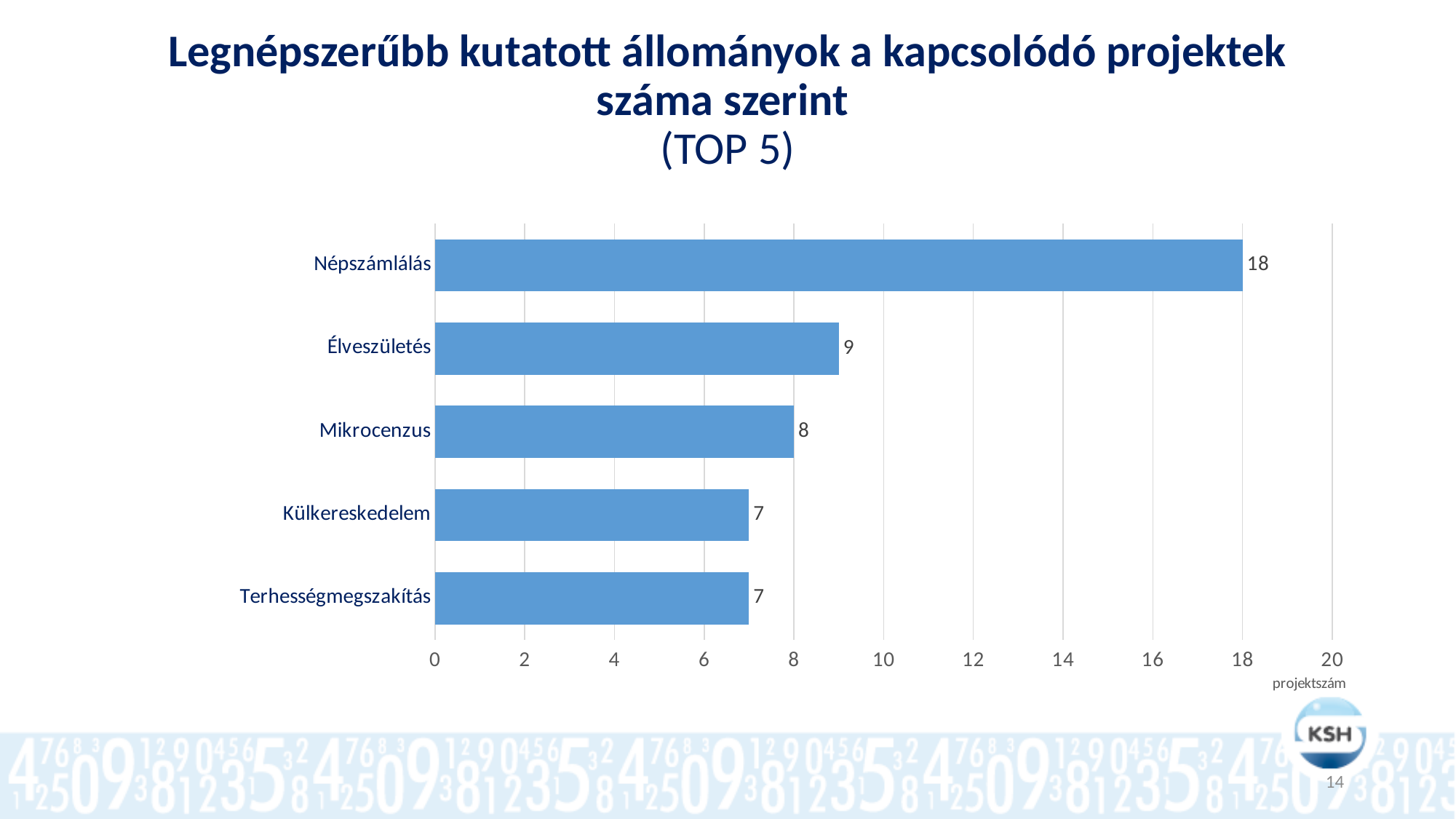
How many categories are shown in the chart? 5 What is the value for Élveszületés? 9 What is the difference between the values for Élveszületés and Mikrocenzus? 1 What is the value for Külkereskedelem? 7 What kind of chart is shown on the slide? bar chart What is the value for Népszámlálás? 18 What is the difference between the values for Népszámlálás and Élveszületés? 9 Is the value for Népszámlálás greater or less than 10? greater Which is larger, the value for Mikrocenzus or the value for Külkereskedelem? Mikrocenzus What is the label shown under the x axis? projektszám What is the value for Mikrocenzus? 8 Which category has the highest value? Népszámlálás